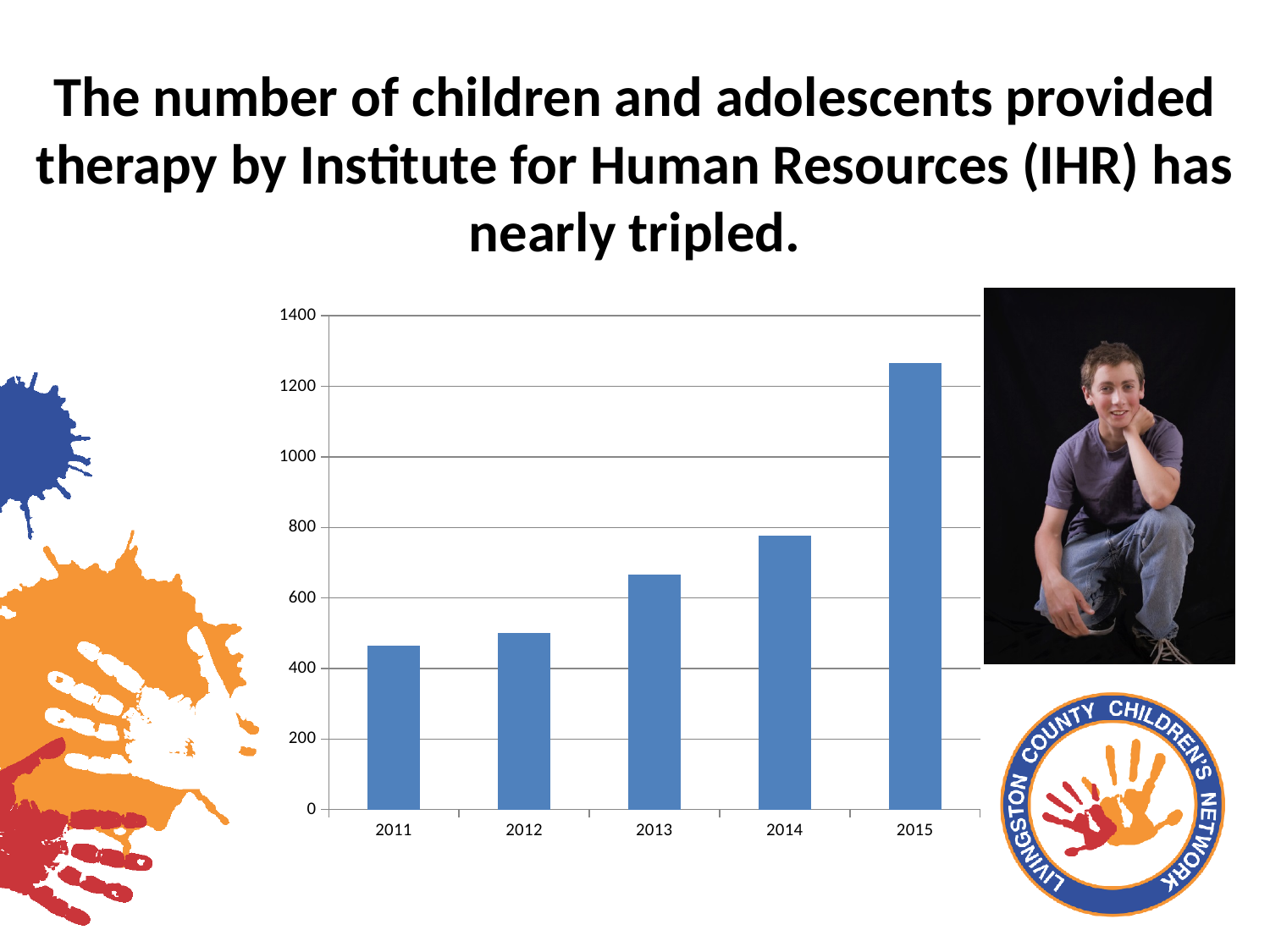
Which is larger, the value for 2013 or the value for 2011? 2013 Which year has the lowest bar in the chart? 2011 Is the value for 2013 greater or less than 600? greater Is the value for 2012 greater or less than 400? greater What kind of chart is shown on the slide? bar chart What is the maximum value shown on the vertical axis of the chart? 1400 Is the value for 2014 greater or less than 1000? less How many years are shown on the x axis of the chart? 5 Do the values rise or fall from 2011 to 2015? rise Which year has the highest bar in the chart? 2015